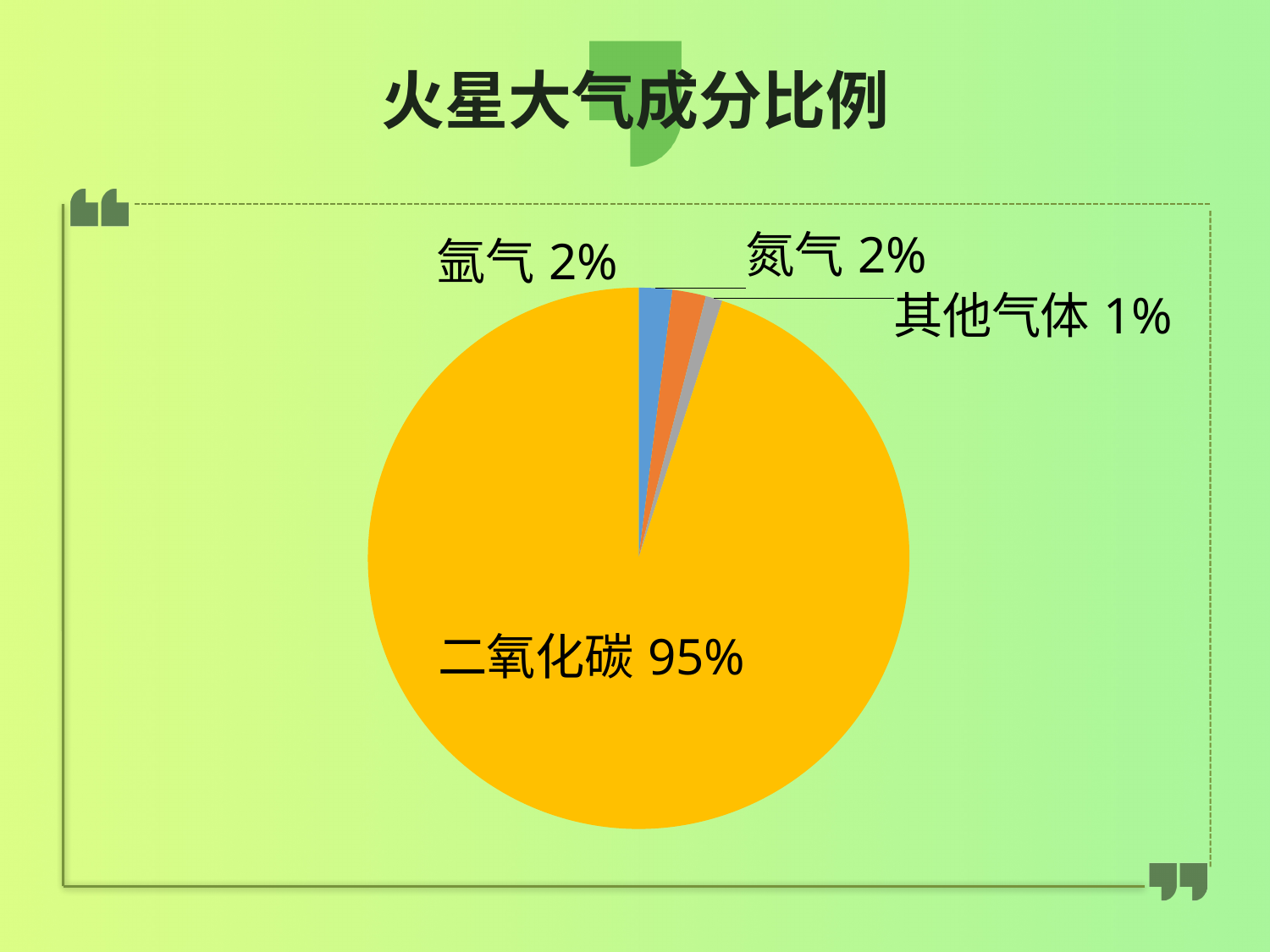
What is the title of the chart? 火星大气成分比例 What is the difference between the values for 二氧化碳 and 氮气? 93% What is the value shown for 氮气? 2% What colour is the slice for 二氧化碳? orange-yellow Which category has the smallest slice of the pie? 其他气体 What share of the pie does 二氧化碳 take? 95% What is the value shown for 氩气? 2% What kind of chart is shown on the slide? pie chart How many categories are shown in the pie chart? 4 Which category has the largest slice of the pie? 二氧化碳 What is the value shown for 其他气体? 1% Which is larger, the value for 氩气 or the value for 其他气体? 氩气